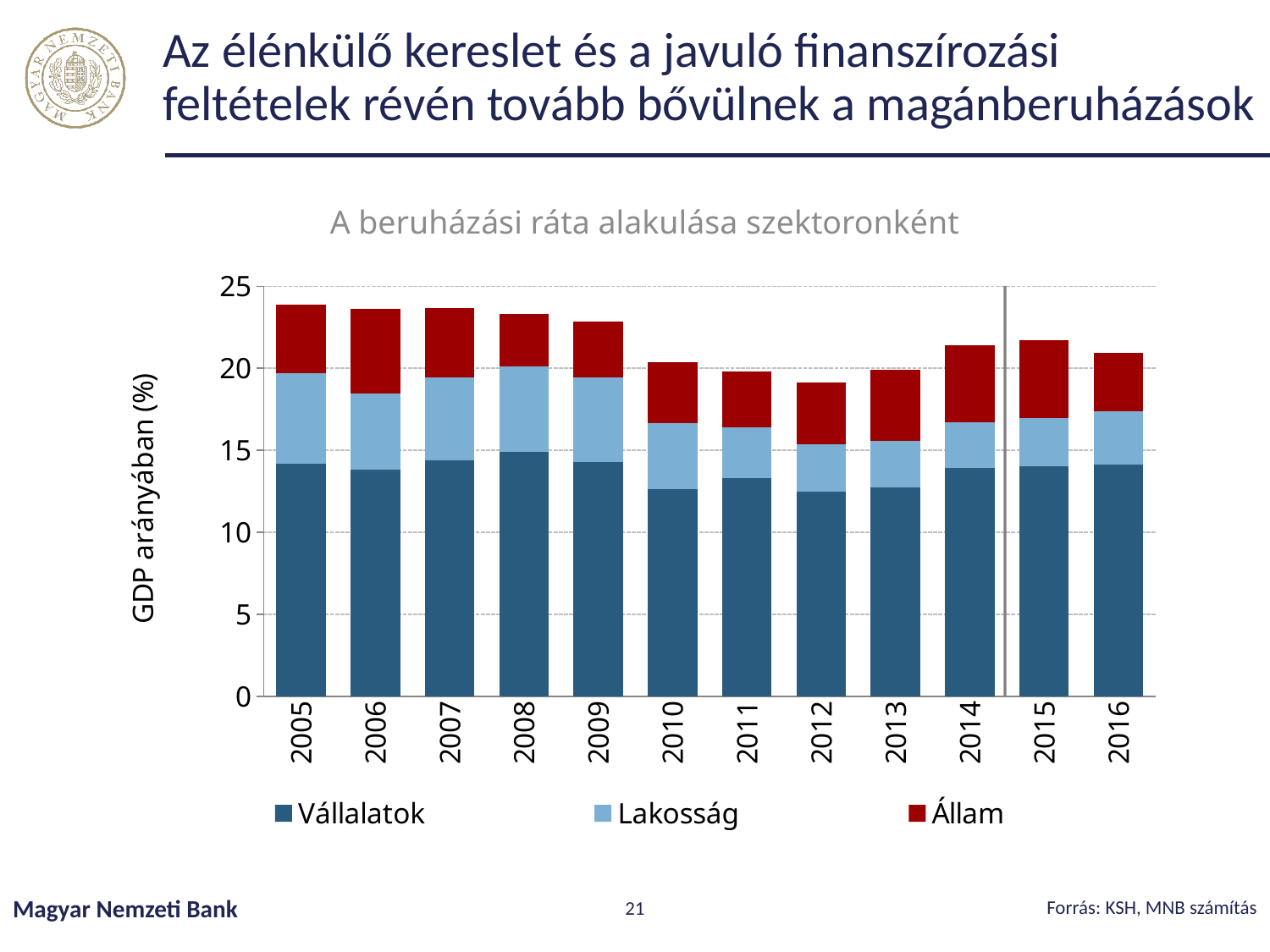
What is the label of the vertical axis of the chart? GDP arányában (%) Is the total stacked value for 2005 greater or less than 20? greater How many years are shown on the x axis of the chart? 12 Which year has the lowest total stacked bar? 2012 How many series does the chart's legend list? 3 What is the title of the chart? A beruházási ráta alakulása szektoronként Is the Vállalatok value for 2012 greater or less than 10? greater Do the total stacked values rise or fall from 2005 to 2012? fall Which total stacked bar is larger, 2005 or 2012? 2005 What kind of chart is shown on the slide? stacked bar chart Is the total stacked value for 2012 greater or less than 20? less